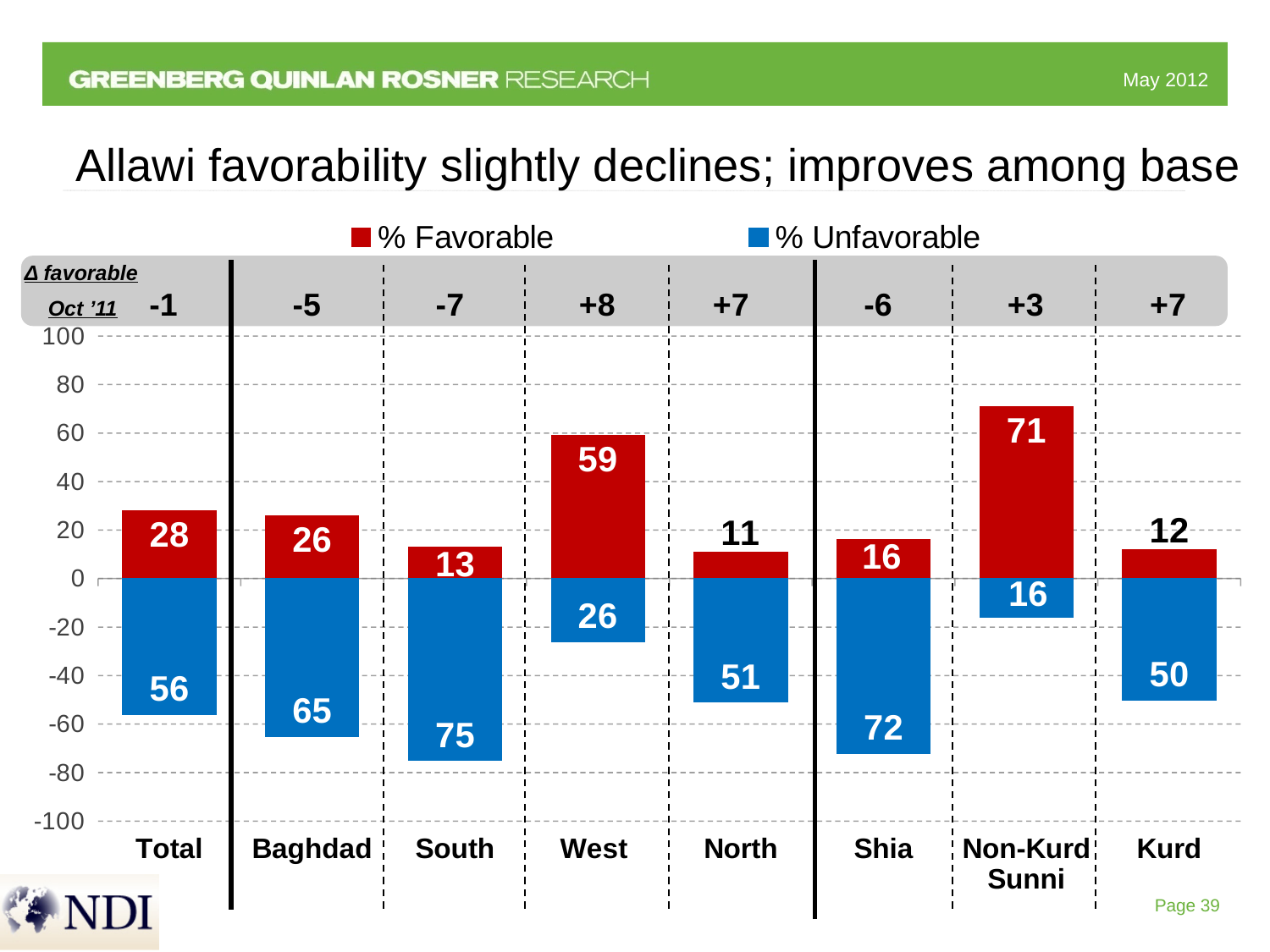
What is the % Unfavorable value for Kurd? 50 Which category has the highest % Favorable value? Non-Kurd Sunni How many series does the legend list? 2 Which category has the lowest % Favorable value? North What is the % Unfavorable value for South? 75 Which is larger, the % Favorable value for Baghdad or for Shia? Baghdad How many categories are shown on the x axis? 8 What kind of chart is shown on the slide? Bar chart What is the difference between the % Unfavorable and % Favorable values for Total? 28 What is the % Favorable value for Non-Kurd Sunni? 71 What is the % Favorable value for West? 59 Which category has the highest % Unfavorable value? South